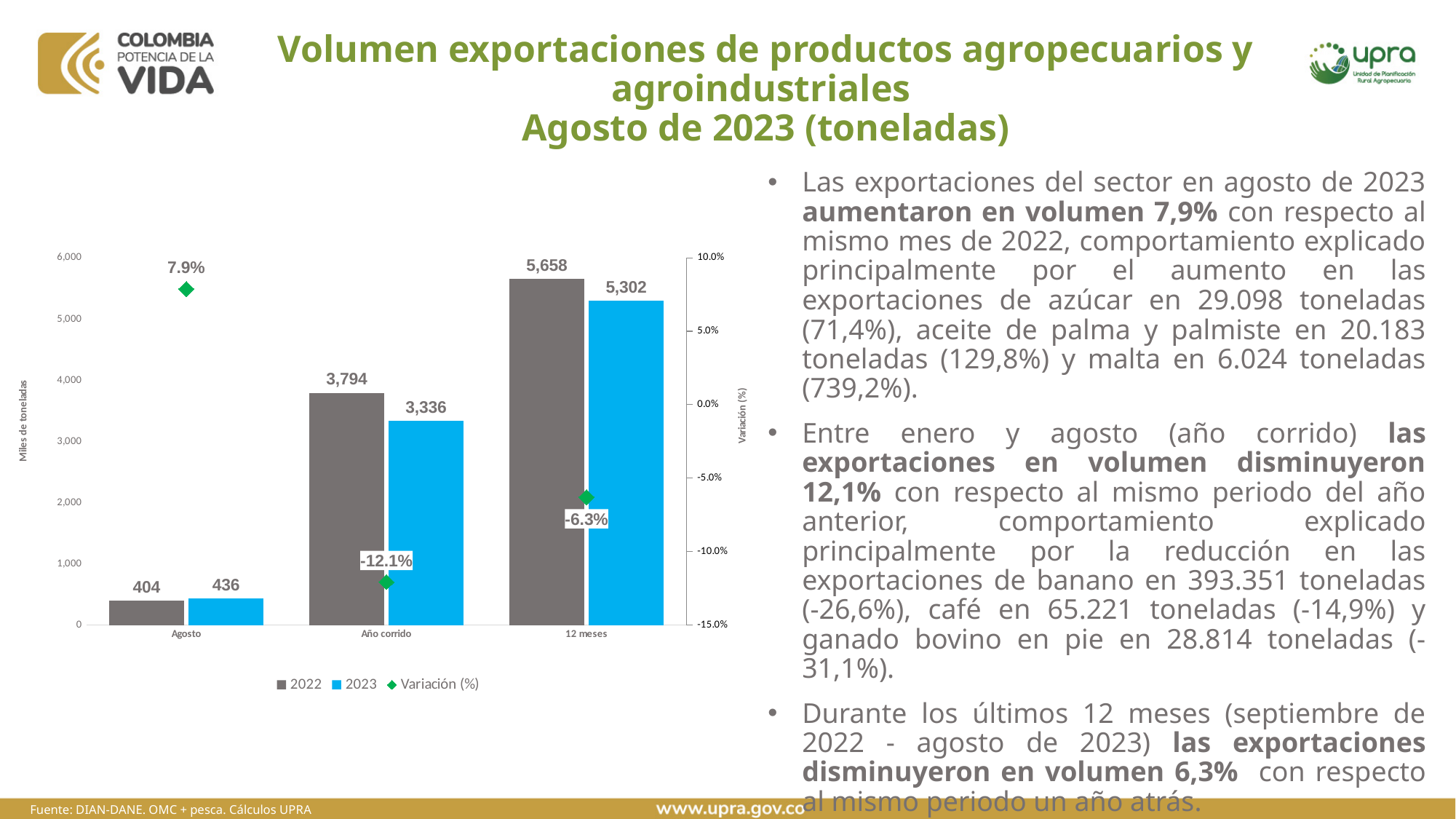
Which category has the highest 2022 value? 12 meses What is the difference between the 2022 and 2023 values for 12 meses? 356 What is the difference between the 2022 and 2023 values for Año corrido? 458 What is the Variación (%) value for 12 meses? -6.3% For Agosto, which is larger, the 2022 value or the 2023 value? 2023 How many categories are shown on the x axis? 3 What is the label of the left vertical axis? Miles de toneladas What is the 2022 value for Agosto? 404 How many series does the legend list? 3 What is the 2023 value for Año corrido? 3,336 What is the Variación (%) value for Agosto? 7.9% Which category has the lowest 2023 value? Agosto